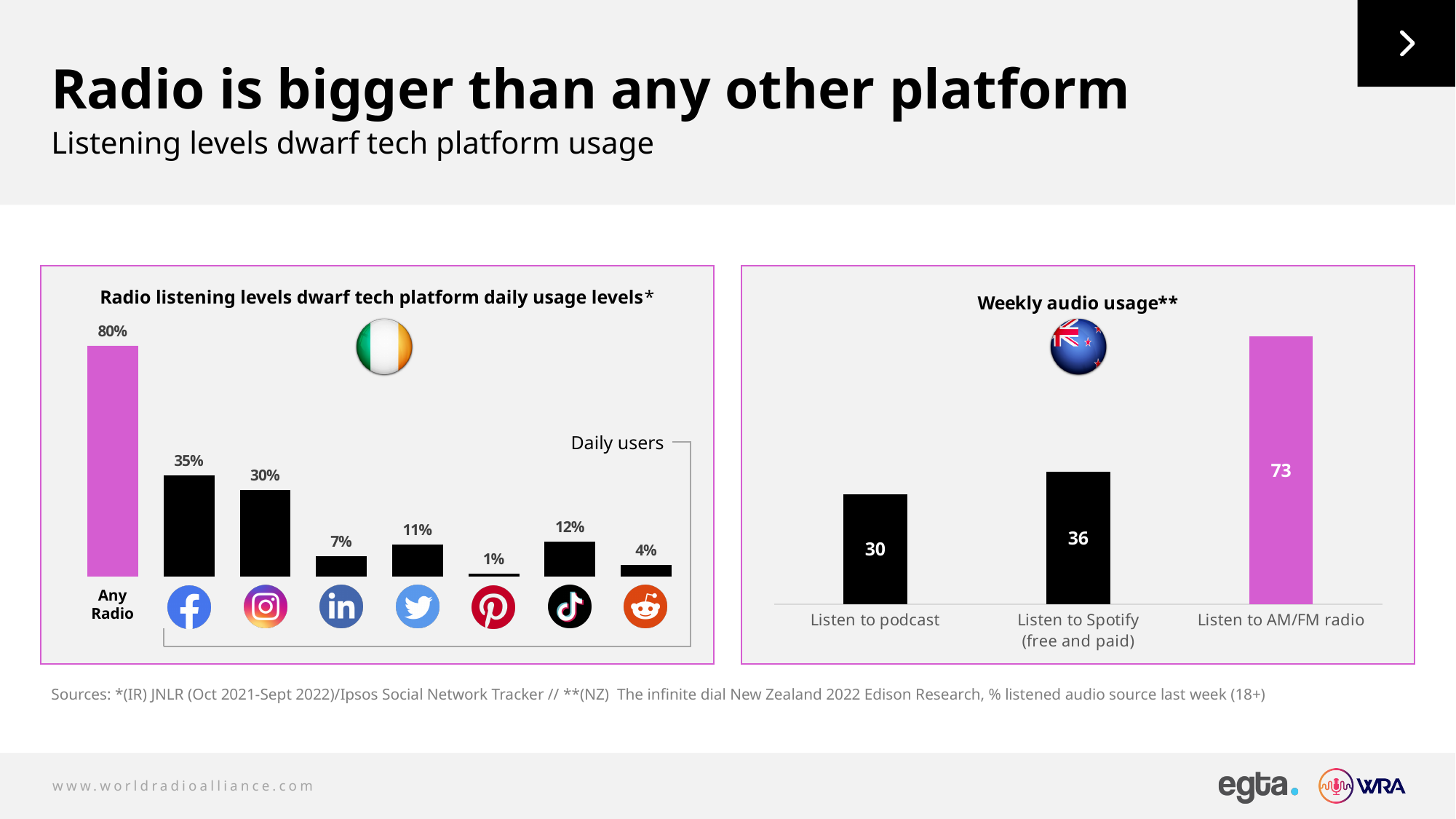
In the 'Weekly audio usage**' chart, what is the value for 'Listen to Spotify (free and paid)'? 36 In the 'Weekly audio usage**' chart, what is the difference between 'Listen to AM/FM radio' and 'Listen to Spotify (free and paid)'? 37 In the 'Weekly audio usage**' chart, which category has the highest value? Listen to AM/FM radio In the 'Radio listening levels dwarf tech platform daily usage levels*' chart, what is the value for 'Any Radio'? 80% In the 'Weekly audio usage**' chart, what is the value for 'Listen to AM/FM radio'? 73 In the 'Radio listening levels dwarf tech platform daily usage levels*' chart, how many bars are shown? 8 In the 'Weekly audio usage**' chart, how many categories are shown? 3 In the 'Radio listening levels dwarf tech platform daily usage levels*' chart, what colour is the 'Any Radio' bar? Pink/magenta In the 'Weekly audio usage**' chart, which category has the lowest value? Listen to podcast In the 'Radio listening levels dwarf tech platform daily usage levels*' chart, what is the lowest value shown? 1% What kind of chart is the 'Weekly audio usage**' chart? Bar chart In the 'Weekly audio usage**' chart, what is the value for 'Listen to podcast'? 30